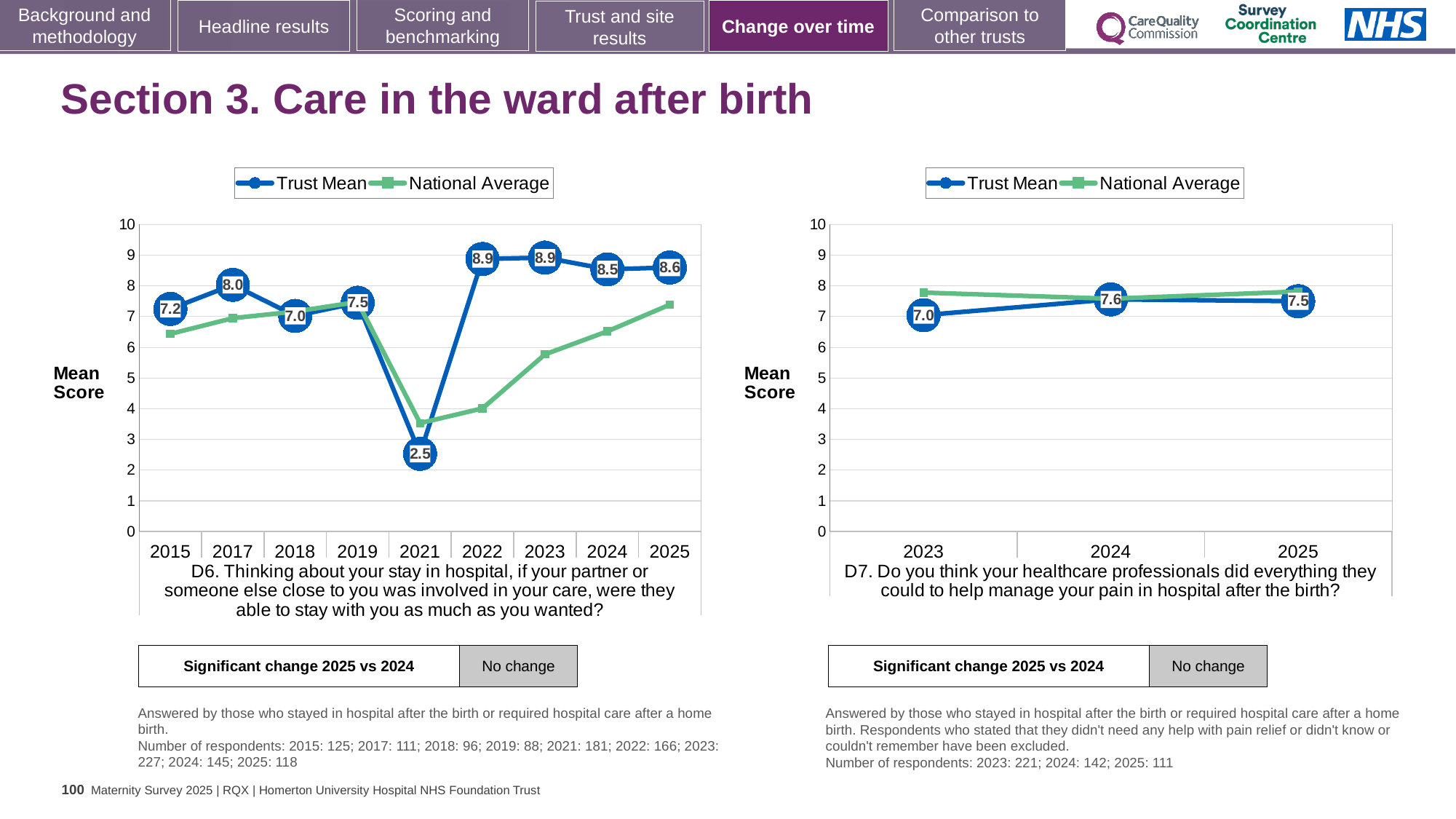
In the D6 chart on the left, what is the Trust Mean score for 2021? 2.5 What kind of chart is the D7 chart on the right? Line chart In the D6 chart on the left, in 2021 which is higher, the Trust Mean or the National Average? National Average In the D6 chart on the left, is the National Average for 2021 greater or less than 4? less How many series does the legend of the D7 chart on the right list? 2 In the D6 chart on the left, what is the Trust Mean score for 2025? 8.6 In the D7 chart on the right, what is the Trust Mean score for 2023? 7.0 In the D7 chart on the right, which year has the highest Trust Mean score? 2024 How many years are plotted in the D6 chart on the left? 9 In the D7 chart on the right, what is the difference between the Trust Mean scores for 2025 and 2023? 0.5 In the D6 chart on the left, which year has the lowest Trust Mean score? 2021 In the D6 chart on the left, what is the difference between the Trust Mean scores for 2025 and 2024? 0.1